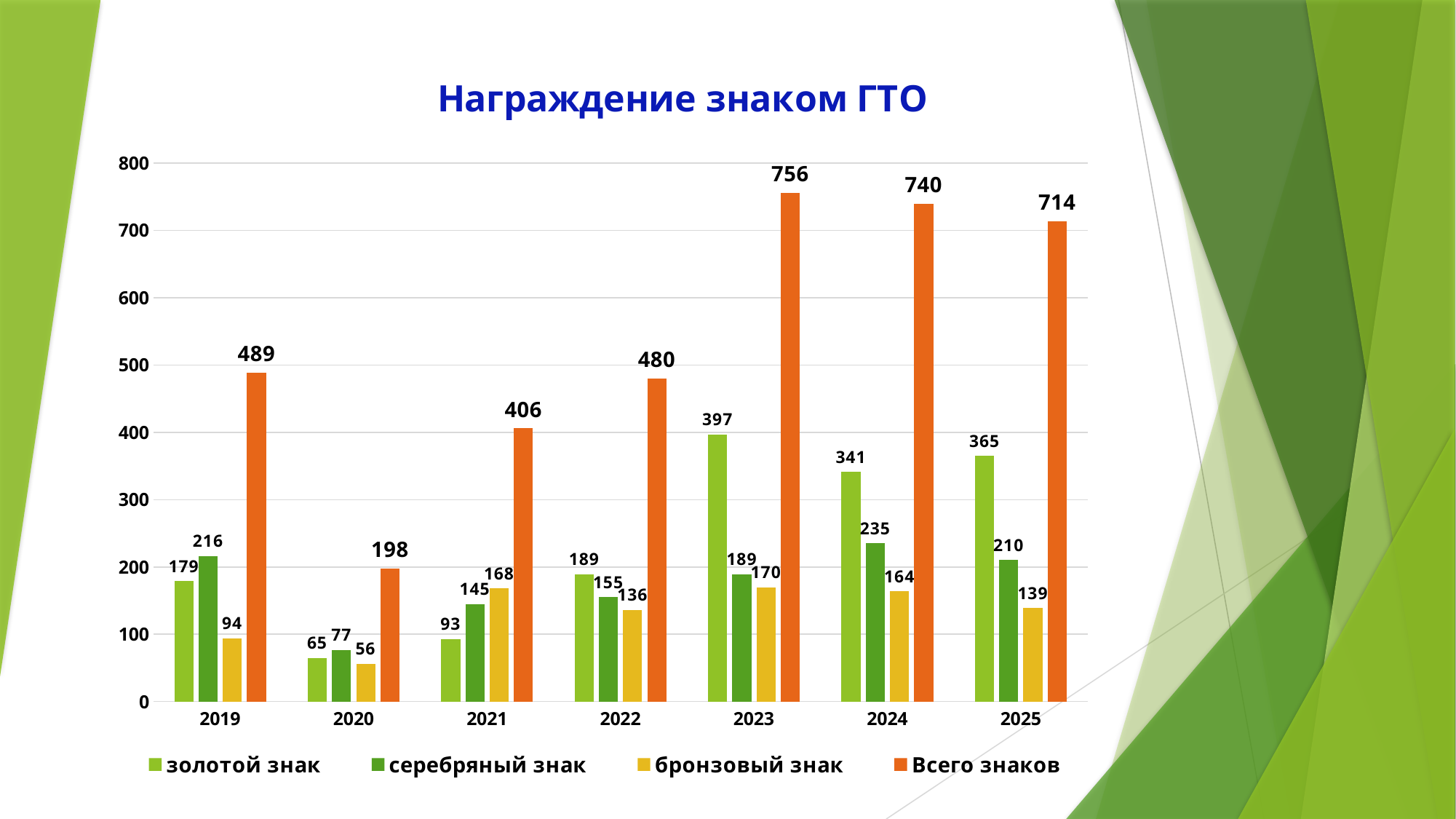
Which is larger: "золотой знак" in 2019 or "серебряный знак" in 2019? серебряный знак in 2019 What is the title of the chart? Награждение знаком ГТО Which year has the highest value for "Всего знаков"? 2023 Which year has the lowest value for "серебряный знак"? 2020 What is the value of "бронзовый знак" for 2020? 56 What is the value of "золотой знак" for 2024? 341 How many series does the legend list? 4 What is the value of "Всего знаков" for 2023? 756 Does the value of "золотой знак" rise or fall from 2020 to 2023? Rise What is the difference between "Всего знаков" in 2024 and in 2025? 26 How many years are shown on the x axis? 7 What kind of chart is shown on the slide? Bar chart